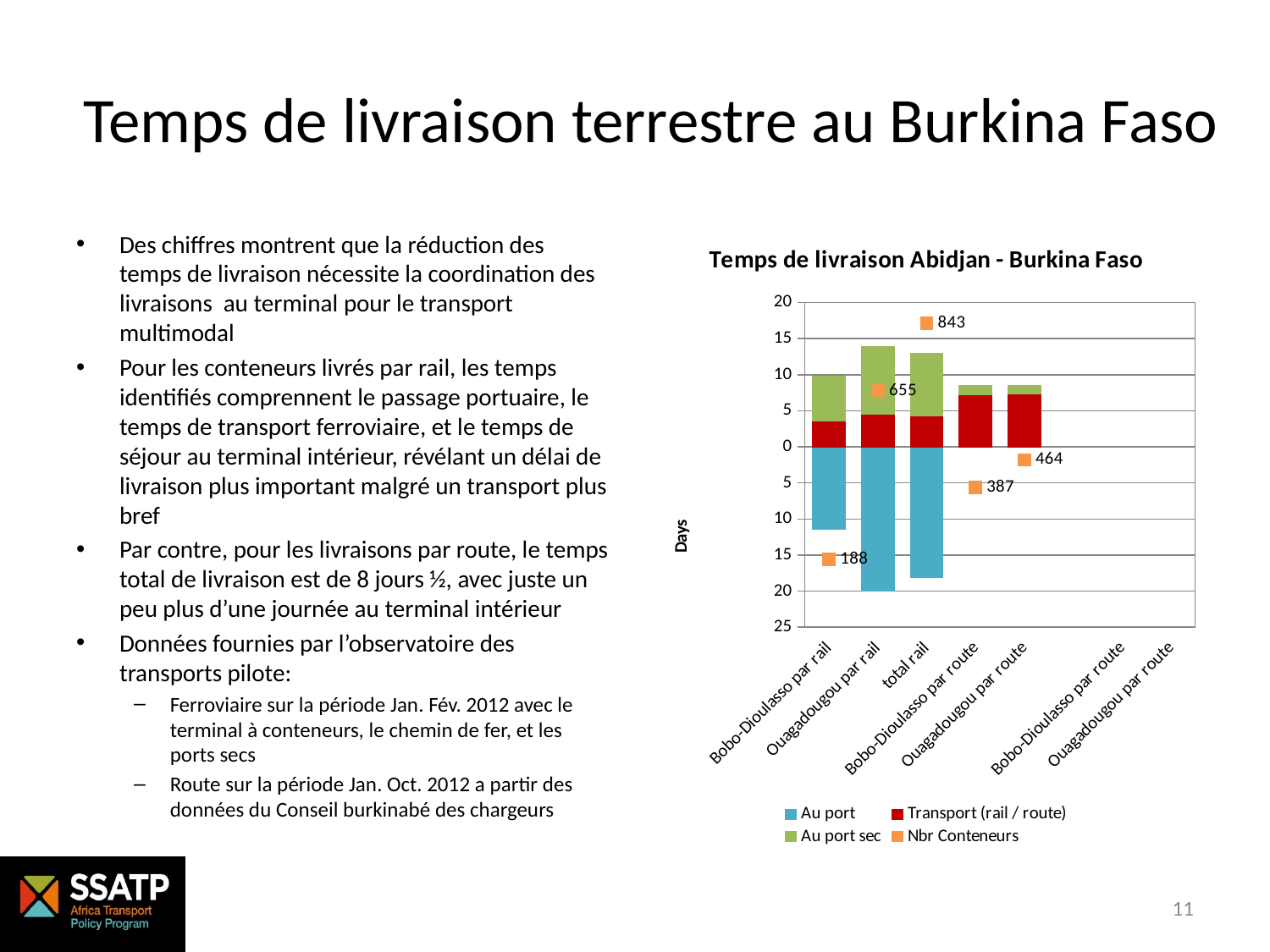
How many series does the chart legend list? 4 What is the difference between the Nbr Conteneurs values for total rail and Ouagadougou par rail? 188 What is the Nbr Conteneurs value for Ouagadougou par rail? 655 What kind of chart is shown on the slide? bar chart What is the title of the chart? Temps de livraison Abidjan - Burkina Faso Which category has the lowest Nbr Conteneurs value? Bobo-Dioulasso par rail Is the Au port value for Bobo-Dioulasso par rail greater or less than 10 days? greater Which has a larger Nbr Conteneurs value, Bobo-Dioulasso par route or Ouagadougou par route? Ouagadougou par route What is the Nbr Conteneurs value for total rail? 843 What is the Nbr Conteneurs value for Bobo-Dioulasso par rail? 188 What is the Nbr Conteneurs value for Ouagadougou par route? 464 Which category has the highest Nbr Conteneurs value? total rail